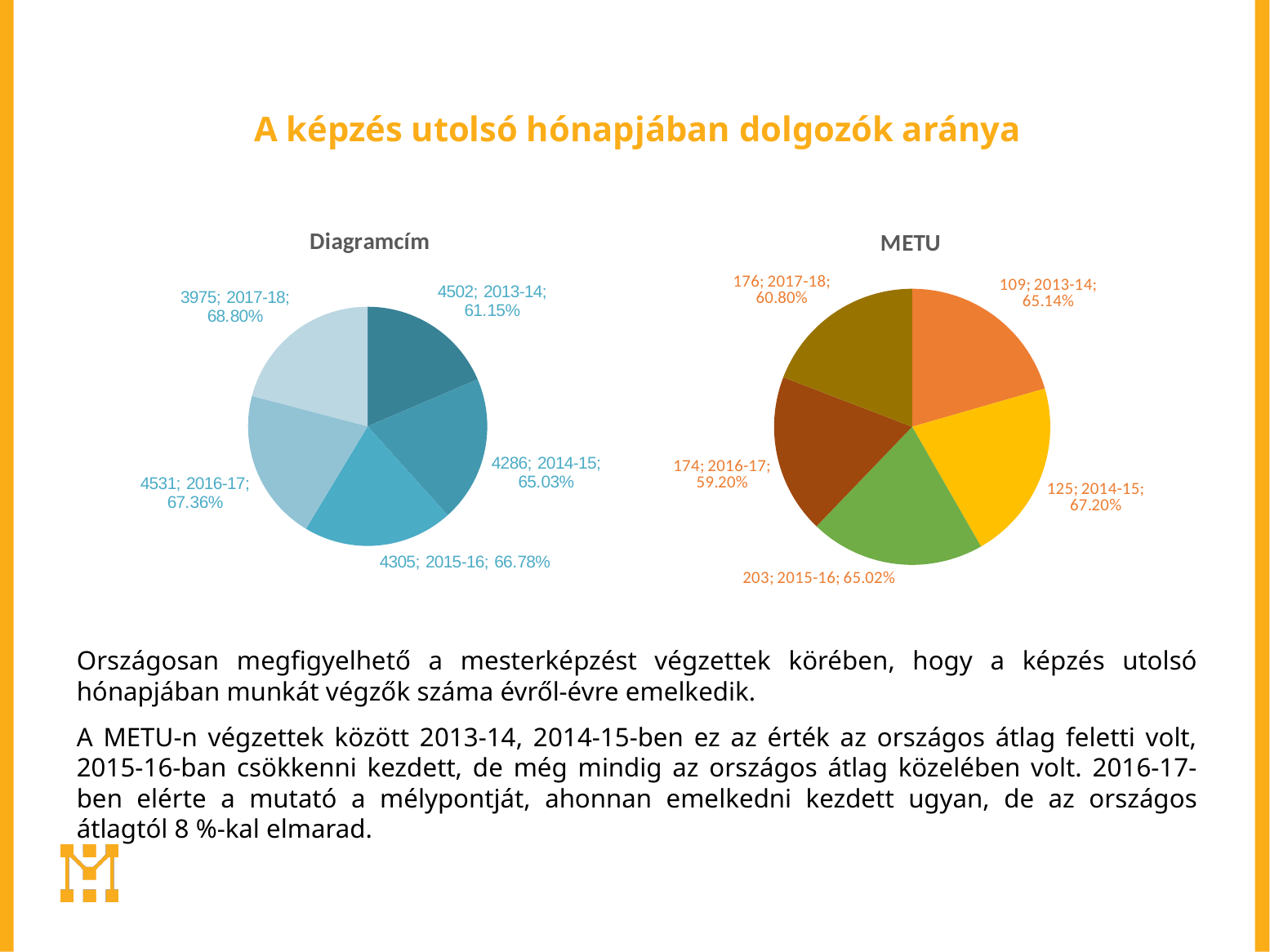
How many slices does the chart titled "METU" have? 5 In the chart titled "METU", what percentage is printed in the label for 2016-17? 59.20% In the chart titled "Diagramcím", what value is shown for 2013-14? 61.15% In the chart titled "Diagramcím", which category has the smallest value? 2013-14 In the chart titled "METU", which is larger, the value for 2014-15 or the value for 2017-18? 2014-15 In the chart titled "Diagramcím", which category has the largest value? 2017-18 In the chart titled "Diagramcím", what is the difference between the values for 2016-17 and 2017-18? 1.44% In the chart titled "METU", what value is shown for 2015-16? 65.02% What type of chart is the chart titled "METU"? pie chart In the chart titled "METU", what is the difference between the values for 2015-16 and 2013-14? 0.12% In the chart titled "METU", which category has the smallest value? 2016-17 In the chart titled "Diagramcím", what percentage is printed in the label for 2017-18? 68.80%